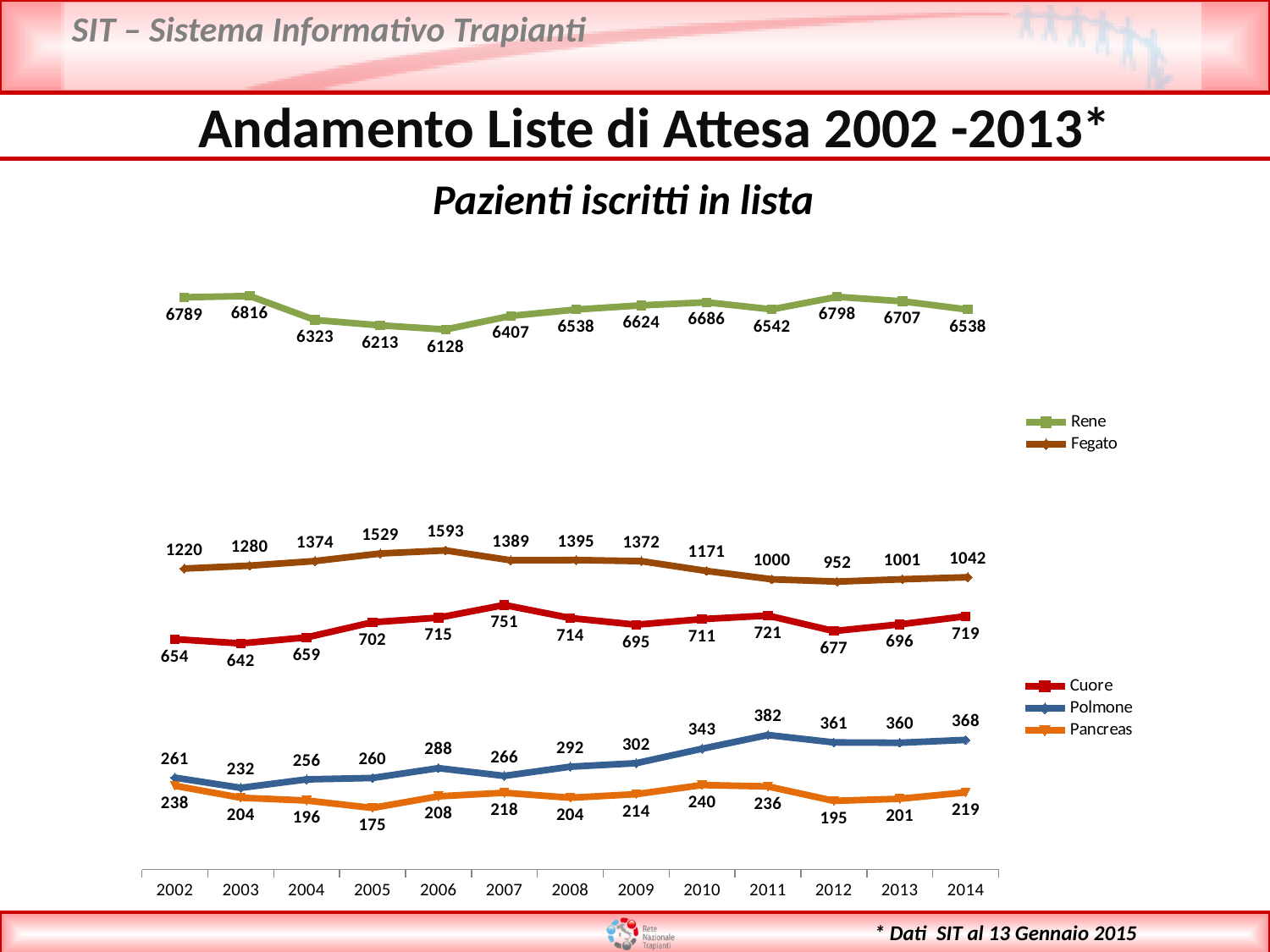
What is the value for Cuore in 2014? 719 How many years are shown on the x axis? 13 What is the value for Rene in 2006? 6128 In which year does the Fegato series reach its highest value? 2006 Which is larger, the Cuore value in 2007 or in 2011? 2007 What is the difference between the Polmone value in 2011 and in 2002? 121 In which year does the Pancreas series reach its lowest value? 2005 What is the value for Fegato in 2011? 1000 What kind of chart is shown on the slide? line chart In which year does the Rene series reach its highest value? 2003 How many series does the legend list? 5 Does the Fegato series rise or fall from 2006 to 2012? fall